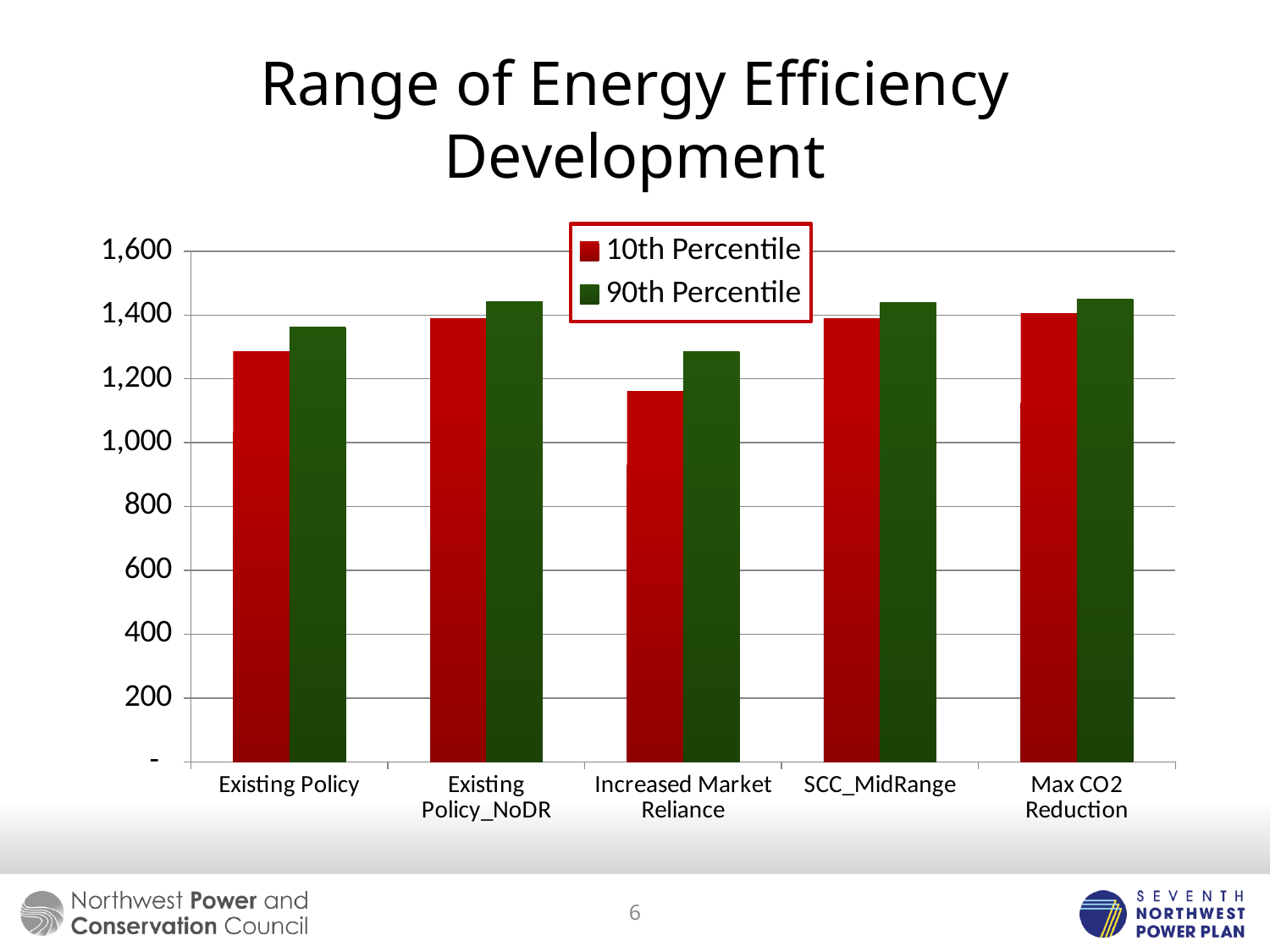
How many categories are shown on the x axis of the chart? 5 What kind of chart is shown on the slide? bar chart What is the title of the chart on the slide? Range of Energy Efficiency Development Is the 10th Percentile value for Existing Policy greater or less than 1,200? greater Which series is shown in green in the chart? 90th Percentile Which is larger: the 90th Percentile value for Existing Policy or the 90th Percentile value for SCC_MidRange? SCC_MidRange Which category has the lowest 10th Percentile value? Increased Market Reliance Which category has the lowest 90th Percentile value? Increased Market Reliance Is the 10th Percentile value for Increased Market Reliance greater or less than 1,200? less Is the 90th Percentile value for Existing Policy_NoDR greater or less than 1,400? greater How many series does the legend list? 2